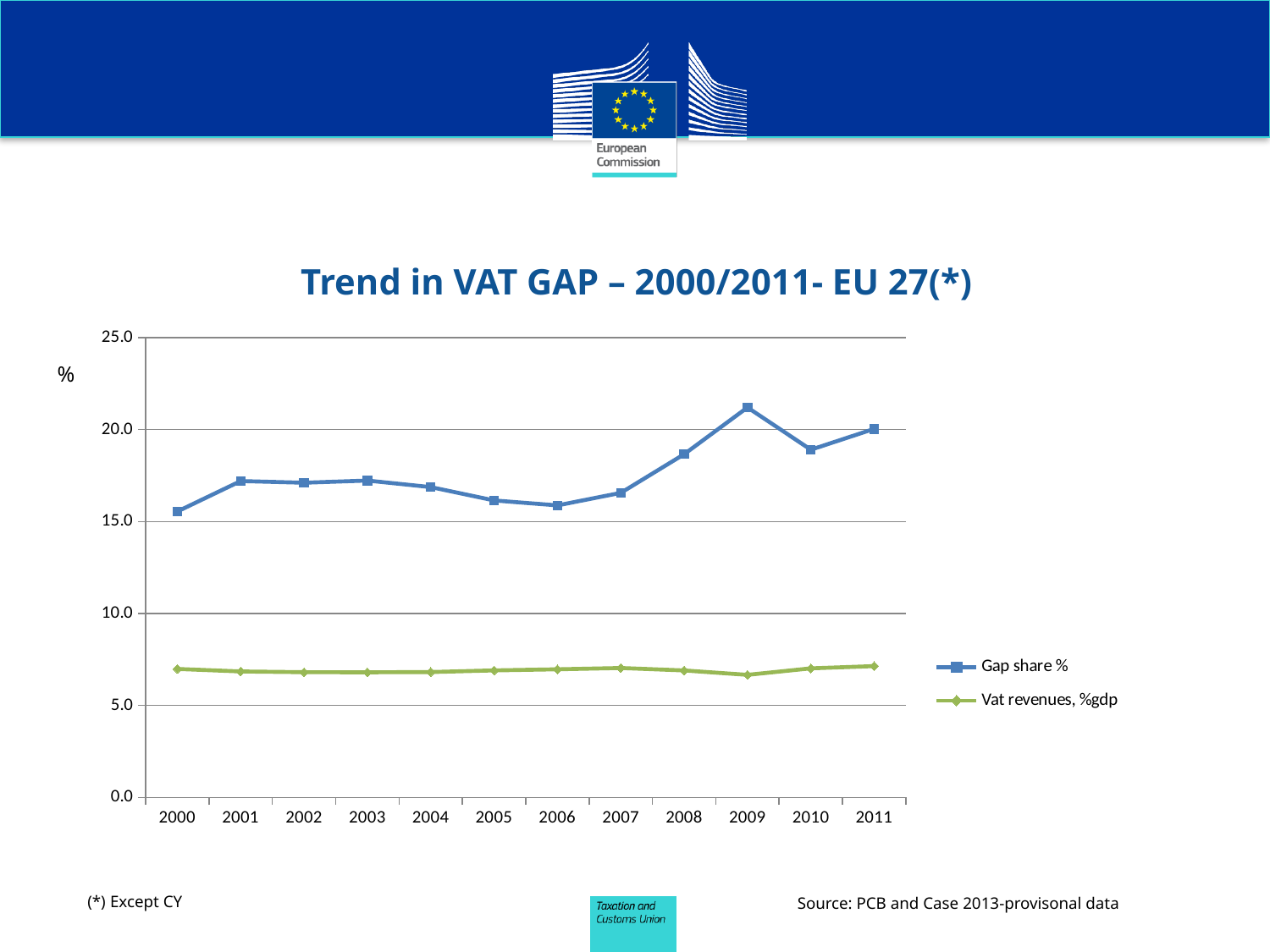
Is the Vat revenues, %gdp value for 2011 greater or less than 10.0? less In which year is the Gap share % at its highest? 2009 Is the Gap share % value for 2009 greater or less than 20.0? greater Does the Gap share % rise or fall between 2006 and 2009? rise What is the title of the chart? Trend in VAT GAP – 2000/2011- EU 27(*) Which is larger, the Gap share % in 2009 or in 2010? 2009 How many years are plotted along the x axis? 12 How many series does the legend list? 2 Which series has the higher value in 2005, Gap share % or Vat revenues, %gdp? Gap share % What kind of chart is shown on the slide? line chart Is the Gap share % value for 2006 greater or less than 20.0? less In which year is the Vat revenues, %gdp series at its lowest? 2009